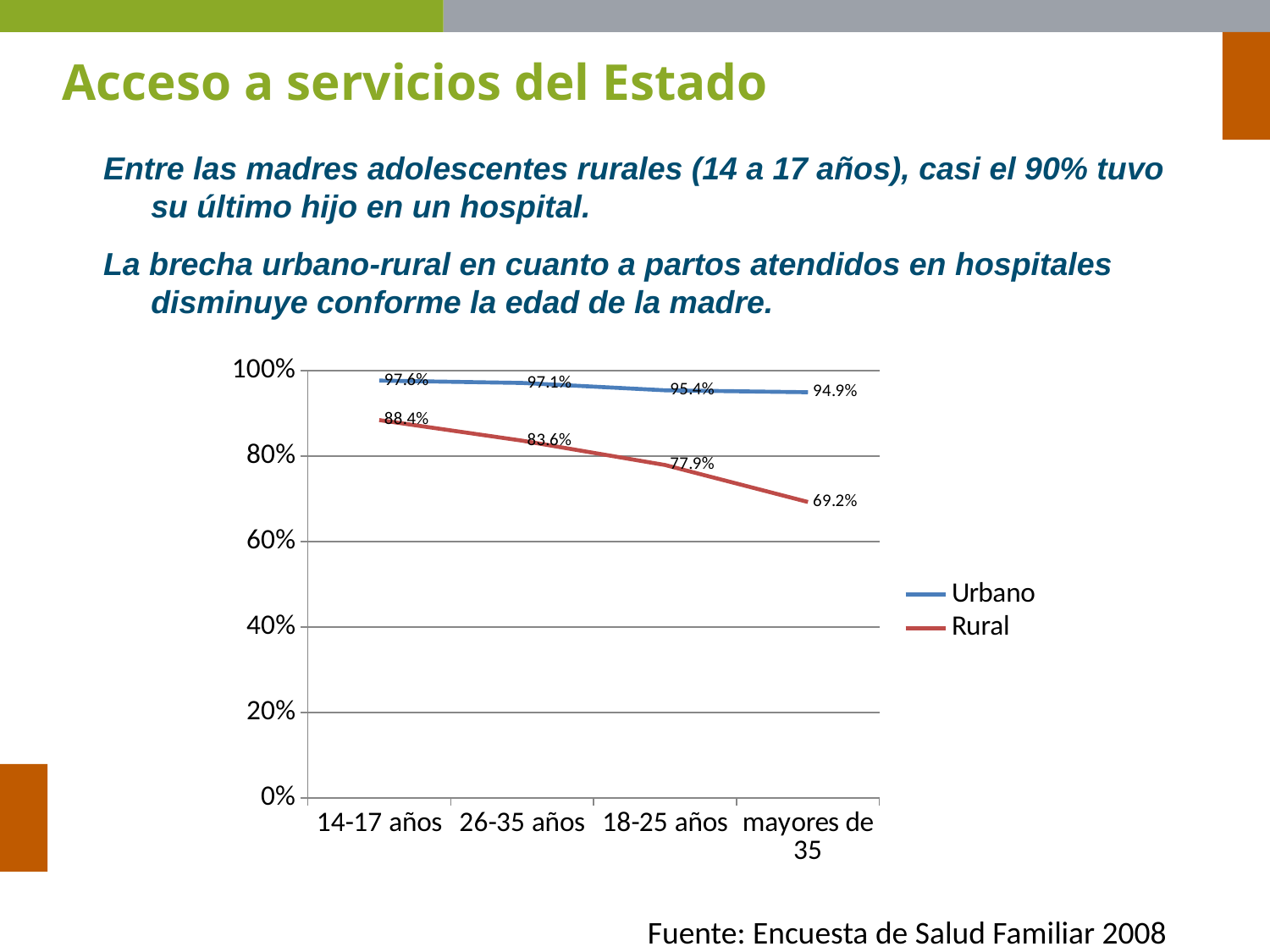
How many series does the legend list? 2 Which age category has the lowest Rural value? mayores de 35 What kind of chart is shown on the slide? line chart What is the Urbano value for 18-25 años? 95.4% What is the Urbano value for 14-17 años? 97.6% How many age categories are shown on the x axis? 4 Which is larger for 18-25 años, the Urbano value or the Rural value? Urbano Which age category has the highest Urbano value? 14-17 años What is the Rural value for mayores de 35? 69.2% What is the difference between the Urbano and Rural values for mayores de 35? 25.7% Does the Rural line rise or fall from left to right along the x axis? fall What is the Rural value for 26-35 años? 83.6%